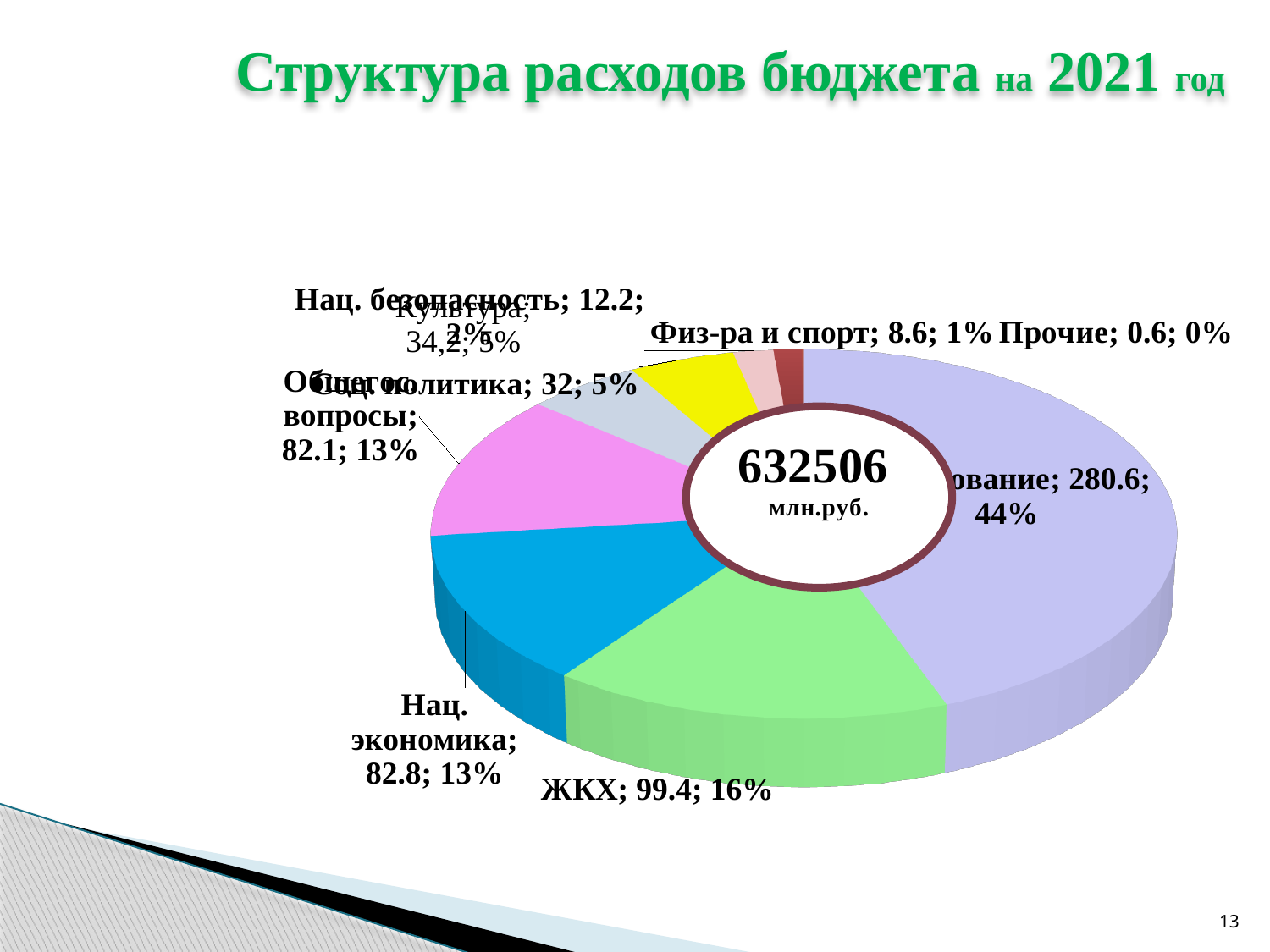
What is the value for Физ-ра и спорт? 8.6 Which category has the largest slice of the pie? Образование Which is larger, the value for Физ-ра и спорт or the value for Прочие? Физ-ра и спорт What share of the pie does ЖКХ represent? 16% Which category has the smallest slice of the pie? Прочие What share of the pie does Прочие represent? 0% What share of the pie does Нац. экономика represent? 13% What is the difference between the values for ЖКХ and Нац. экономика? 16.6 What is the value for ЖКХ? 99.4 What total is printed in the centre of the pie chart? 632506 млн.руб. What kind of chart is shown on the slide? pie chart What is the value for Нац. экономика? 82.8